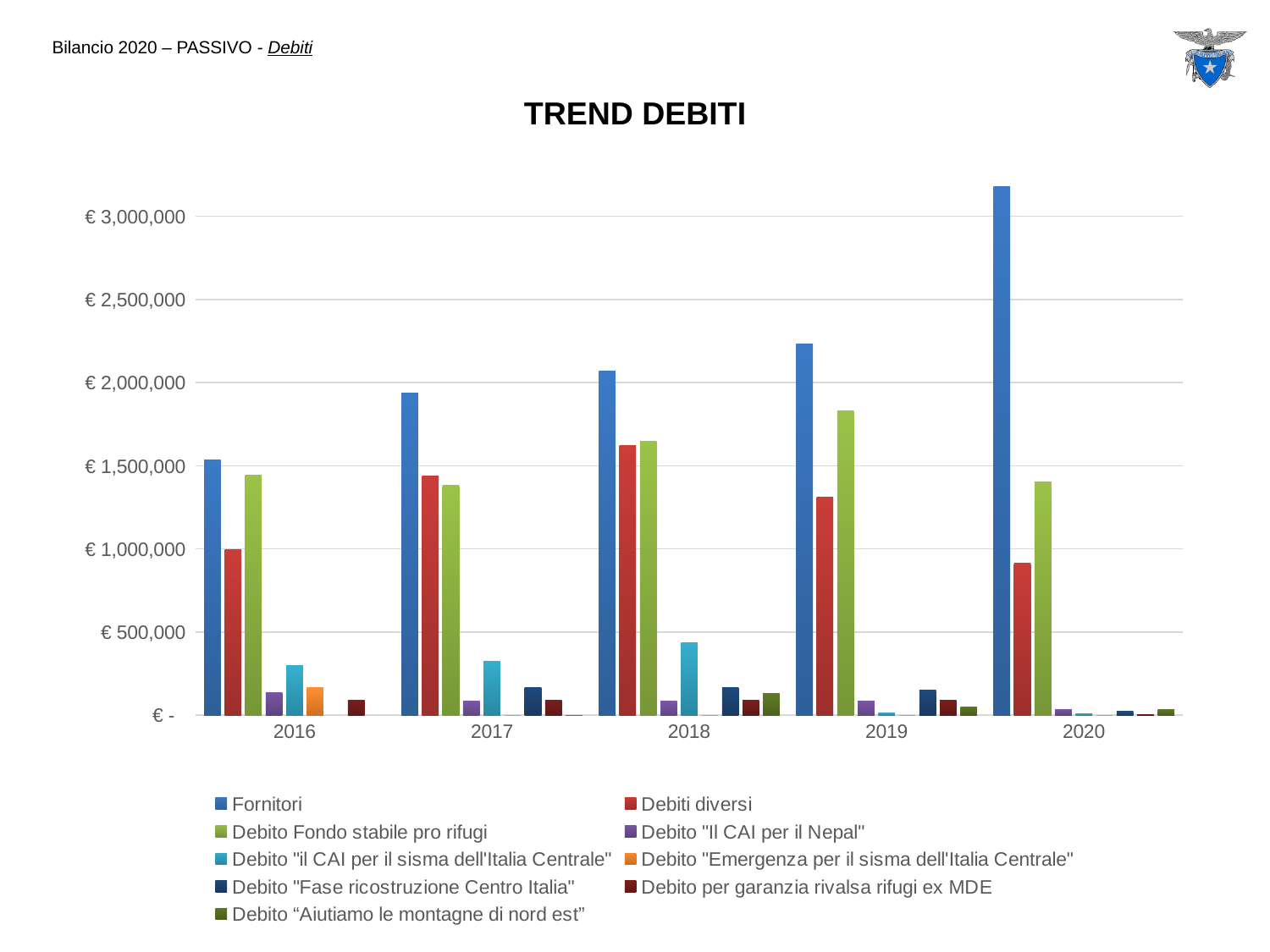
Does the Fornitori series rise or fall from 2016 to 2020? rise What is the title of the chart? TREND DEBITI In 2019, which is larger: Fornitori or Debito Fondo stabile pro rifugi? Fornitori In which year is the Fornitori value lowest? 2016 In 2016, which is larger: Debiti diversi or Debito Fondo stabile pro rifugi? Debito Fondo stabile pro rifugi In which year is the Fornitori value highest? 2020 Is the Debiti diversi value for 2020 greater or less than € 1,000,000? less How many years are shown on the x axis of the chart? 5 Is the value of Debito "il CAI per il sisma dell'Italia Centrale" for 2018 greater or less than € 500,000? less How many series does the legend list? 9 Is the Fornitori value for 2020 greater or less than € 3,000,000? greater What kind of chart is shown on the slide? bar chart